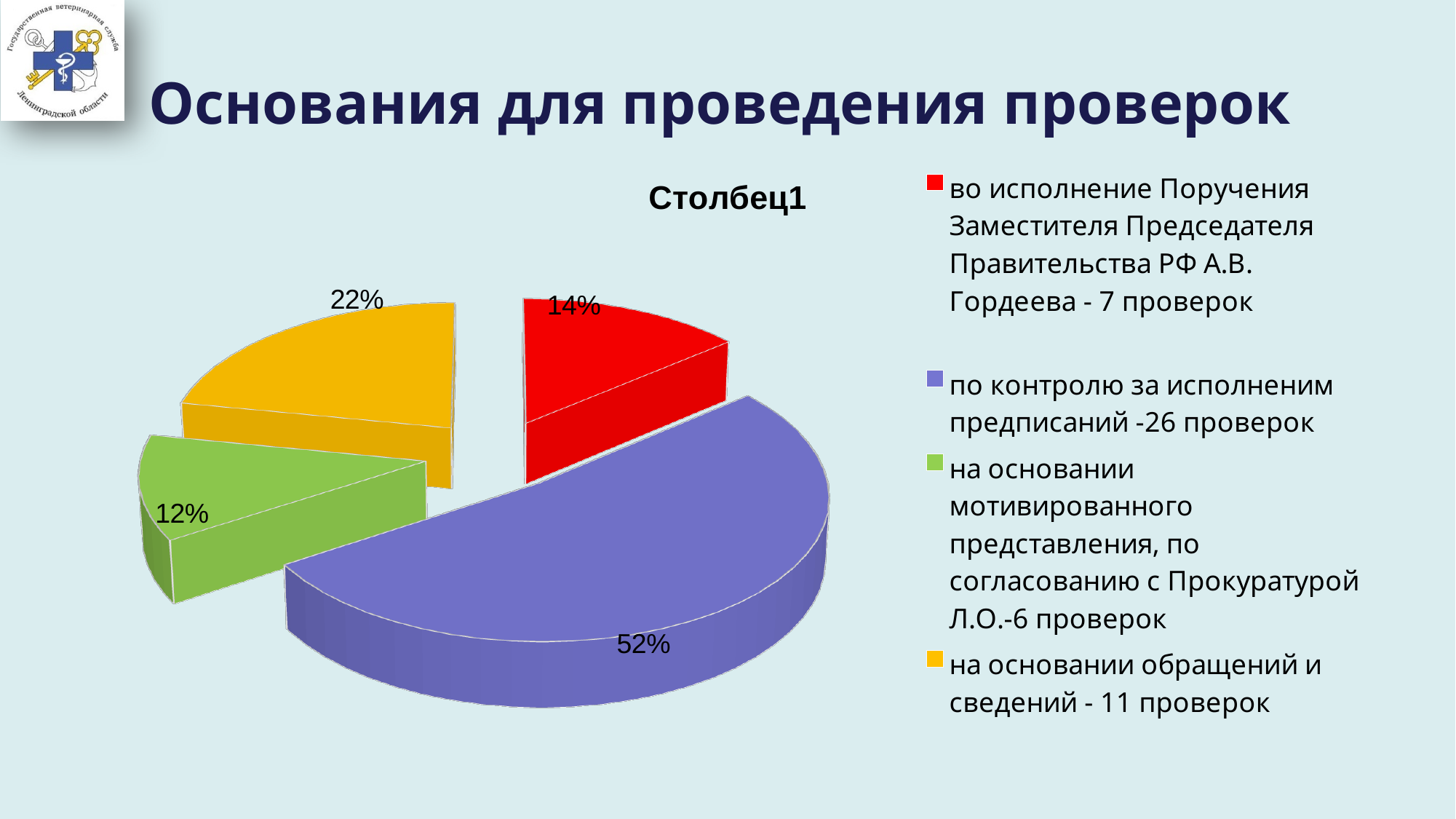
What kind of chart is shown on the slide? pie chart What colour is the slice representing 'по контролю за исполненим предписаний'? purple What percentage is shown for the slice 'по контролю за исполненим предписаний'? 52% What percentage is shown for the slice 'во исполнение Поручения Заместителя Председателя Правительства РФ А.В. Гордеева'? 14% What percentage is shown for the slice 'на основании обращений и сведений'? 22% Which category has the smallest share of the pie? на основании мотивированного представления, по согласованию с Прокуратурой Л.О. What is the chart's title? Столбец1 What is the difference in percentage points between the 52% slice and the 22% slice? 30 How many entries does the legend list? 4 Which is larger: the share for 'на основании обращений и сведений' or the share for 'во исполнение Поручения Заместителя Председателя Правительства РФ А.В. Гордеева'? на основании обращений и сведений How many slices does the pie chart have? 4 Which category has the largest share of the pie? по контролю за исполненим предписаний